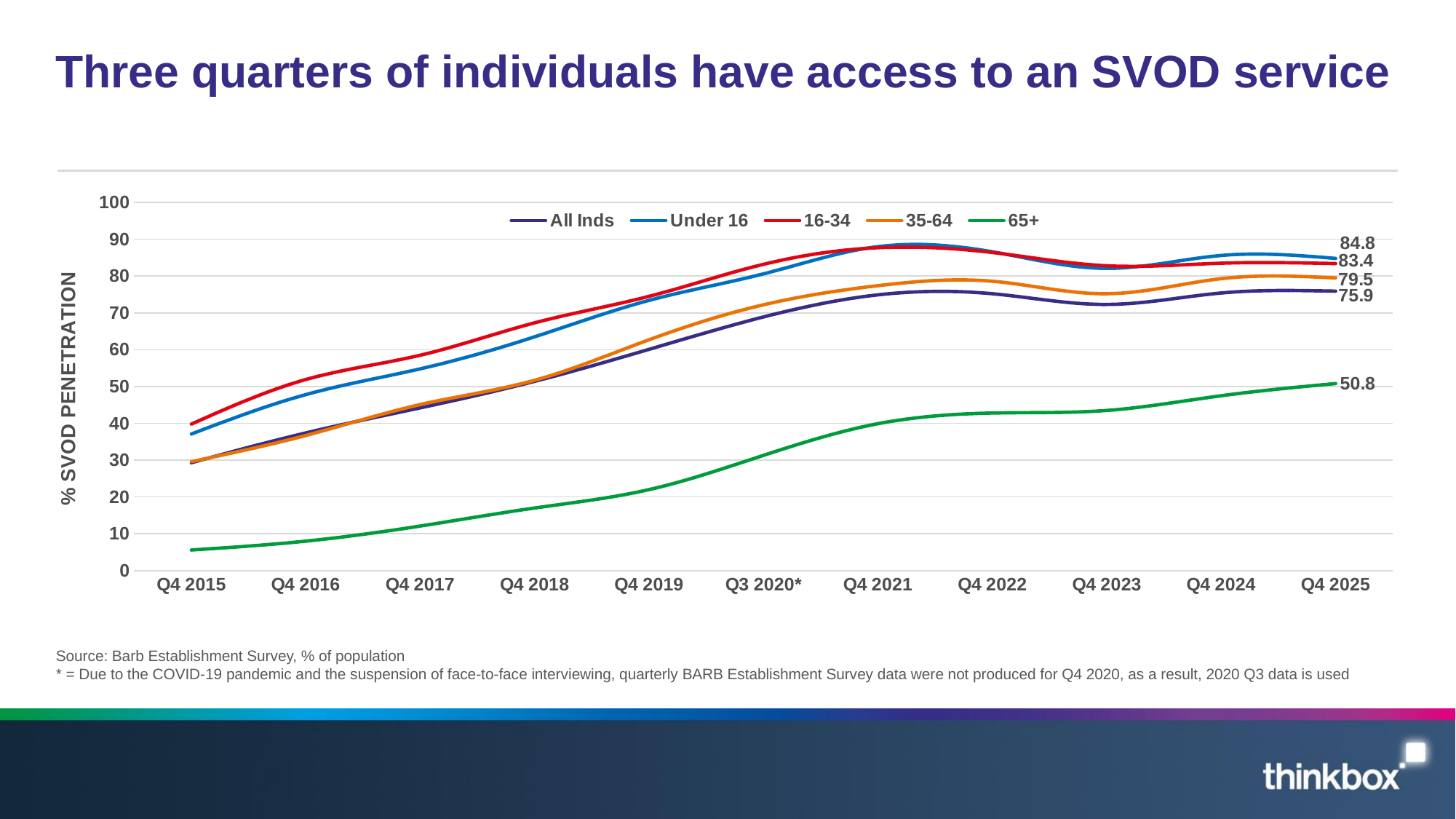
What is the SVOD penetration for 35-64 at Q4 2025? 79.5 How many series does the legend list? 5 What kind of chart is shown on the slide? line chart Which series has the lowest value at Q4 2025? 65+ What is the SVOD penetration for 65+ at Q4 2025? 50.8 What is the difference between the Under 16 and 65+ values at Q4 2025? 34.0 Which series has the highest value at Q4 2025? Under 16 Is the value for 65+ at Q4 2015 greater or less than 10? less What is the SVOD penetration for Under 16 at Q4 2025? 84.8 What is the SVOD penetration for All Inds at Q4 2025? 75.9 Does the 65+ line generally rise or fall from Q4 2015 to Q4 2025? rise How many time points are labelled on the x axis? 11